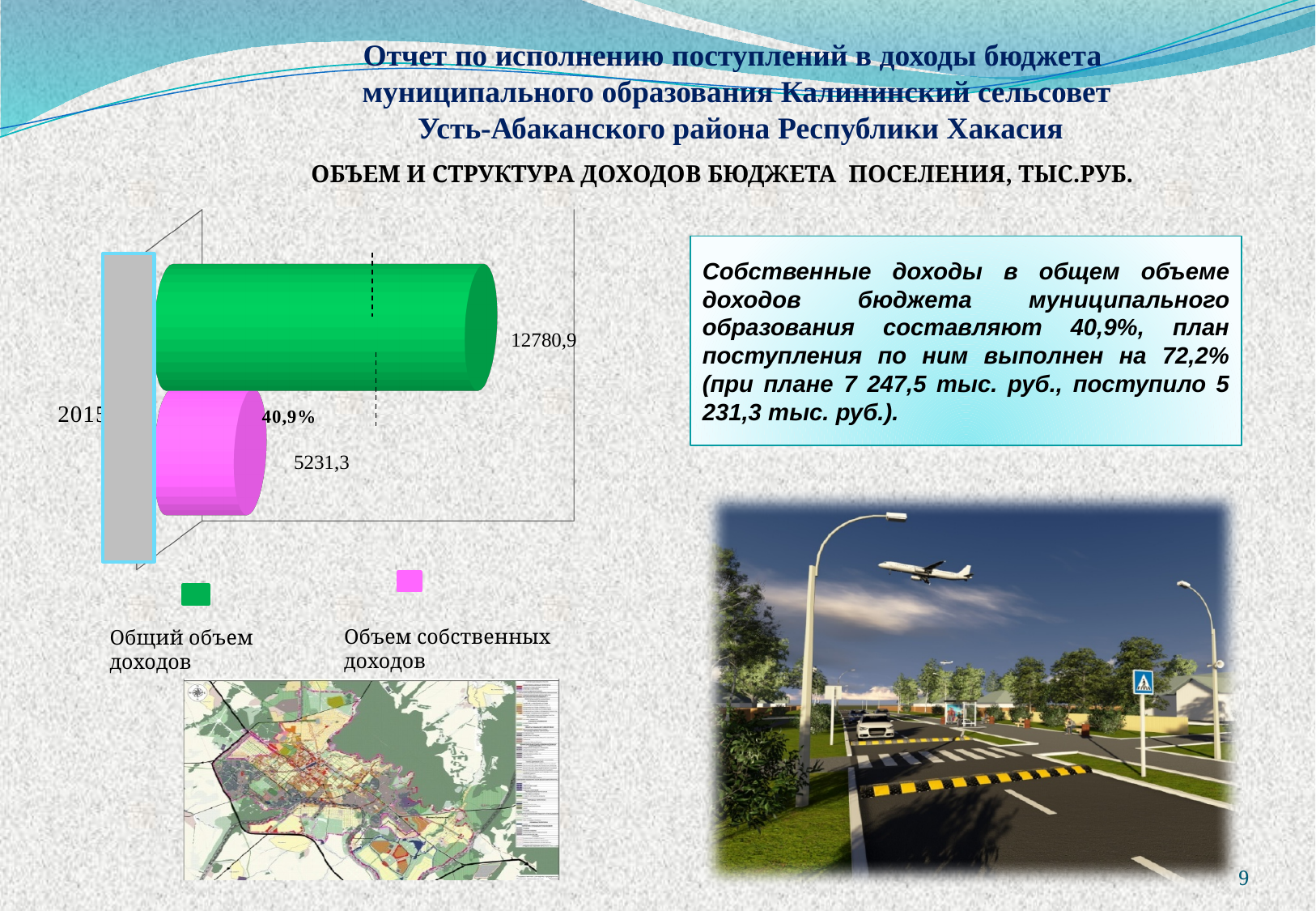
What is the difference between Общий объем доходов and Объем собственных доходов? 7549,6 How many categories are plotted on the chart? 1 What is the value for Общий объем доходов in the chart? 12780,9 How many series does the chart legend list? 2 What colour is the bar for Общий объем доходов? green What kind of chart is shown on the slide? bar chart Which series has the smallest value in the chart? Объем собственных доходов What percentage label is printed next to the Объем собственных доходов bar? 40,9% Which year is shown as the category on the chart's axis? 2015 What is the value for Объем собственных доходов in the chart? 5231,3 Which series has the larger value, Общий объем доходов or Объем собственных доходов? Общий объем доходов